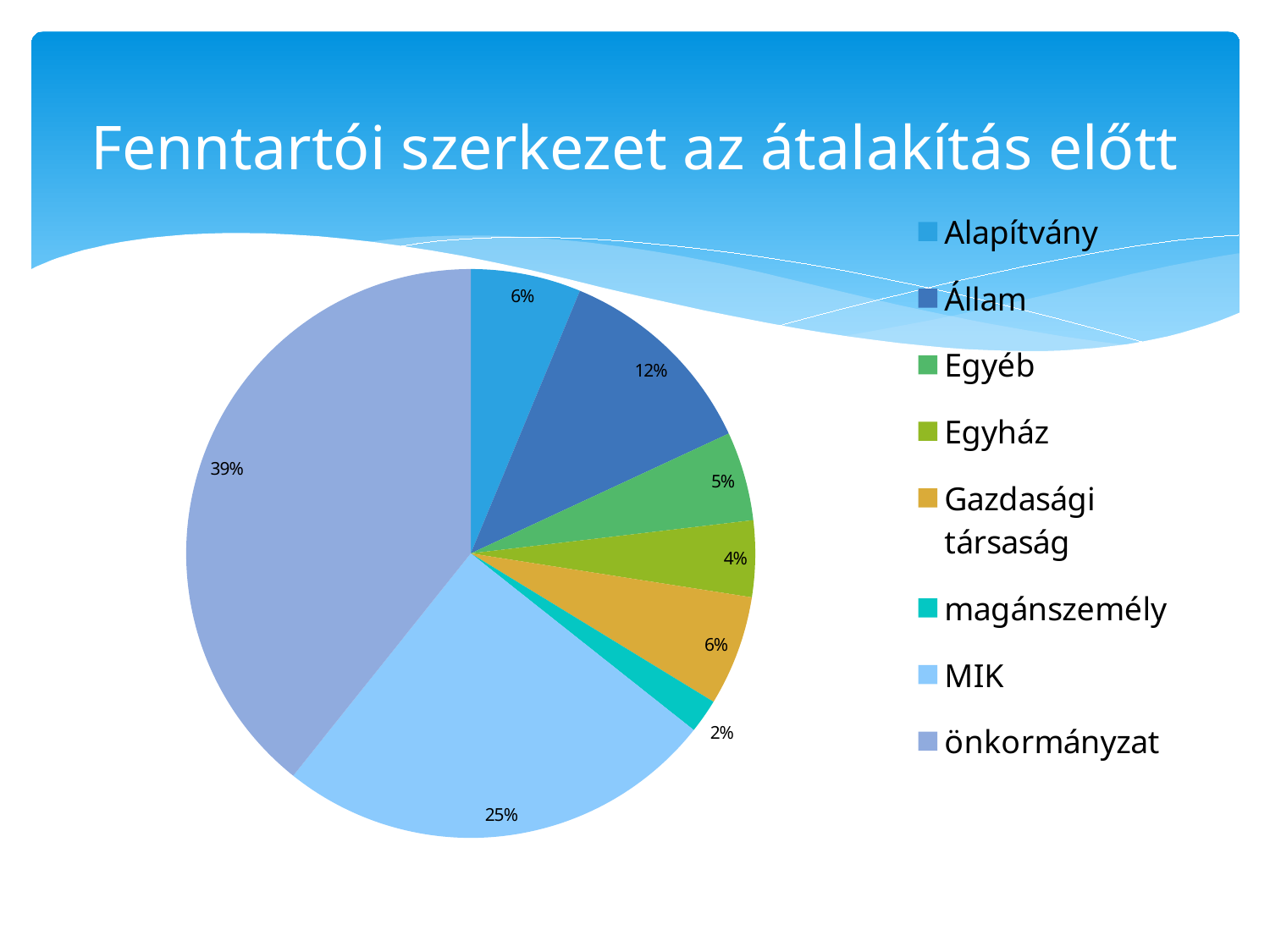
What share of the pie does önkormányzat have? 39% What is the title of the chart? Fenntartói szerkezet az átalakítás előtt Which is larger, the share for Állam or the share for Egyéb? Állam What is the value for Állam? 12% How many categories does the legend list? 8 What is the value for magánszemély? 2% Which category has the smallest share of the pie? magánszemély What is the value for Egyház? 4% What type of chart is shown on the slide? pie chart Which category has the largest share of the pie? önkormányzat What is the difference between the shares of önkormányzat and MIK? 14% What share of the pie does MIK have? 25%